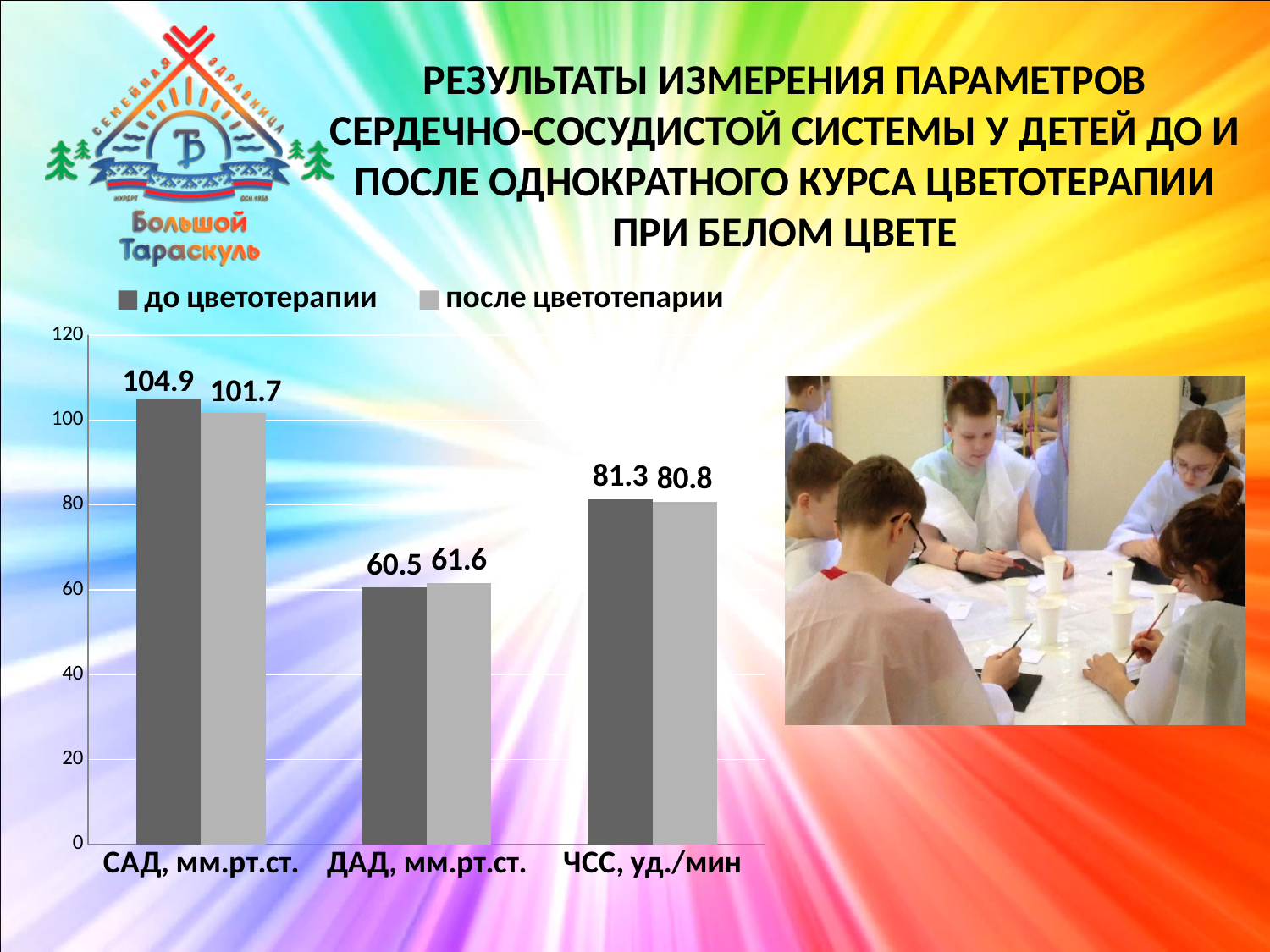
How many series does the chart legend list? 2 What is the difference between the после цветотепарии and до цветотерапии values for ДАД, мм.рт.ст.? 1.1 What is the value for ЧСС, уд./мин in the series после цветотепарии? 80.8 How many categories are shown on the x axis of the chart? 3 Which category has the highest value in the series до цветотерапии? САД, мм.рт.ст. Which category has the lowest value in the series после цветотепарии? ДАД, мм.рт.ст. What is the value for САД, мм.рт.ст. in the series после цветотепарии? 101.7 For ДАД, мм.рт.ст., which series has the larger value: до цветотерапии or после цветотепарии? после цветотепарии What is the value for ДАД, мм.рт.ст. in the series до цветотерапии? 60.5 What kind of chart is shown on the slide? bar chart What is the value for САД, мм.рт.ст. in the series до цветотерапии? 104.9 What is the difference between the до цветотерапии and после цветотепарии values for САД, мм.рт.ст.? 3.2